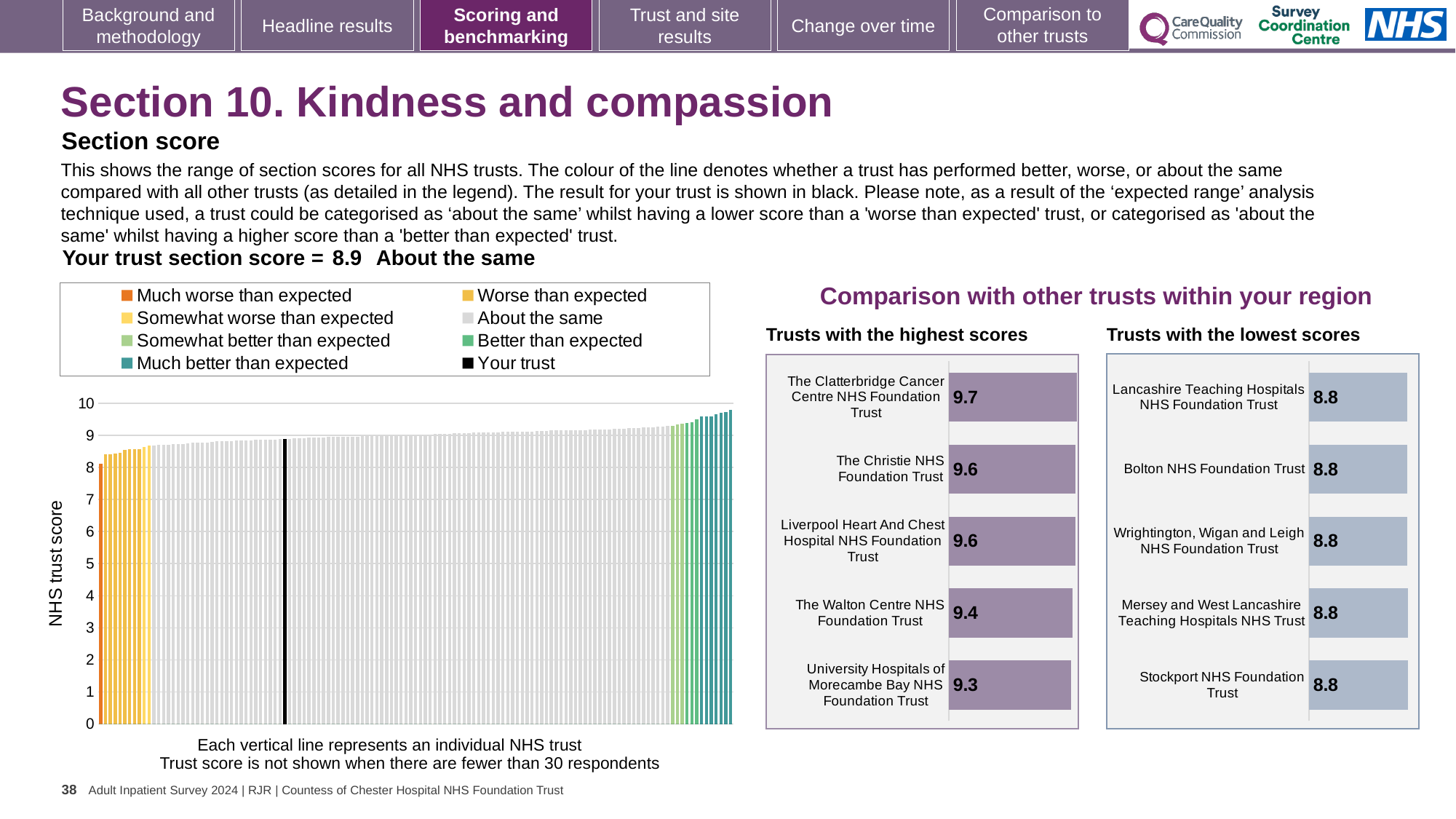
In the 'Trusts with the lowest scores' chart, what is the score for Stockport NHS Foundation Trust? 8.8 In the 'Trusts with the highest scores' chart, which trust has the lowest score? University Hospitals of Morecambe Bay NHS Foundation Trust In the large chart on the left, is the value of the black bar (your trust) greater or less than 8? greater What kind of chart is the large chart on the left showing NHS trust scores? bar chart In the 'Trusts with the highest scores' chart, how many trusts are shown? 5 In the large chart on the left, what is the label on the vertical axis? NHS trust score In the 'Trusts with the lowest scores' chart, what is the score for Bolton NHS Foundation Trust? 8.8 In the 'Trusts with the highest scores' chart, what is the score for The Clatterbridge Cancer Centre NHS Foundation Trust? 9.7 In the large chart on the left, how many entries does the legend list? 8 In the 'Trusts with the highest scores' chart, which has the higher score: The Walton Centre NHS Foundation Trust or University Hospitals of Morecambe Bay NHS Foundation Trust? The Walton Centre NHS Foundation Trust In the 'Trusts with the highest scores' chart, what is the difference between the scores of The Clatterbridge Cancer Centre NHS Foundation Trust and University Hospitals of Morecambe Bay NHS Foundation Trust? 0.4 In the large chart on the left, do the bar values rise or fall from left to right? rise